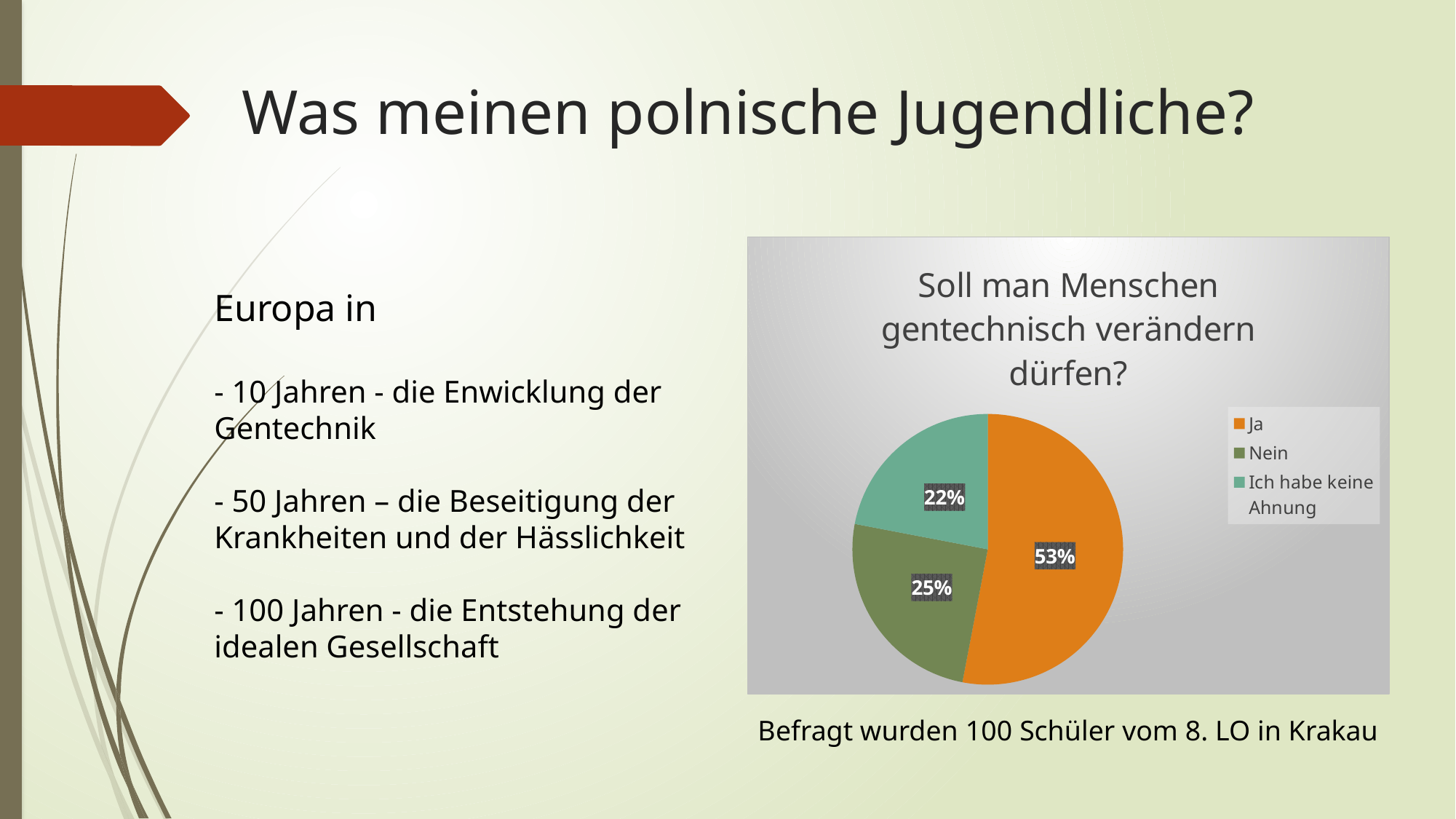
What colour is the "Ja" slice? orange What kind of chart is shown on the slide? pie chart What percentage of respondents answered "Ich habe keine Ahnung"? 22% Which answer has the largest share of the pie? Ja How many slices does the pie chart have? 3 What percentage of respondents answered "Nein"? 25% Which is larger, the share for "Nein" or the share for "Ich habe keine Ahnung"? Nein What is the title of the chart? Soll man Menschen gentechnisch verändern dürfen? How many entries does the legend list? 3 What is the difference in percentage points between "Ja" and "Nein"? 28 Which answer has the smallest share of the pie? Ich habe keine Ahnung What percentage of respondents answered "Ja"? 53%